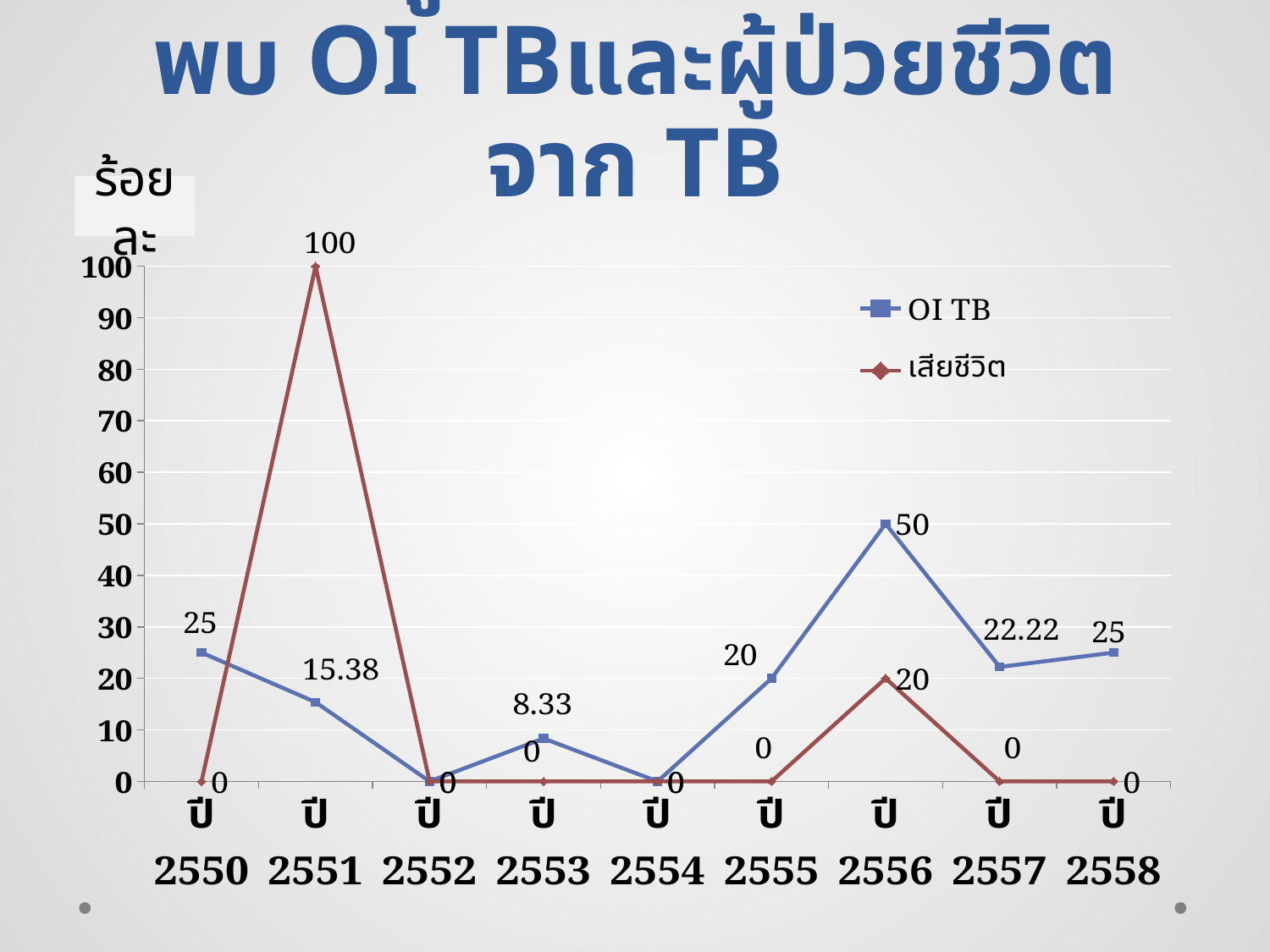
Which is larger for ปี 2551: the OI TB value or the เสียชีวิต value? เสียชีวิต In which year is the OI TB series highest? ปี 2556 What is the difference between the OI TB value for ปี 2556 and the OI TB value for ปี 2555? 30 How many years are shown on the x axis? 9 What kind of chart is shown on the slide? line chart What is the เสียชีวิต value for ปี 2551? 100 Which series is drawn in blue? OI TB In which year is the เสียชีวิต series highest? ปี 2551 What is the OI TB value for ปี 2553? 8.33 What is the OI TB value for ปี 2556? 50 What is the OI TB value for ปี 2557? 22.22 How many series does the legend list? 2